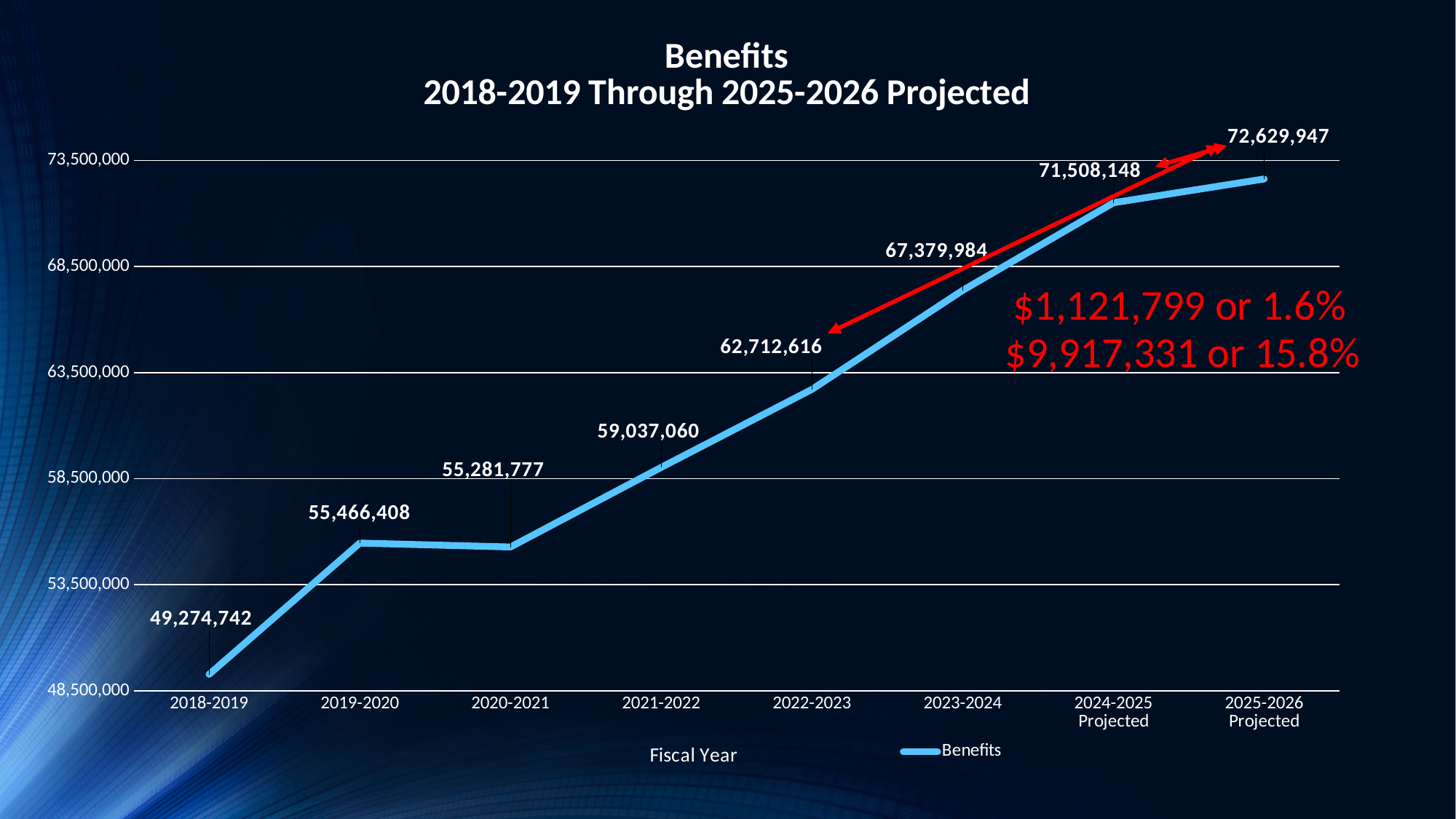
Which is larger, the Benefits value for 2019-2020 or for 2020-2021? 2019-2020 What is the Benefits value for 2022-2023? 62,712,616 Which fiscal year has the highest Benefits value? 2025-2026 Projected What is the projected Benefits value for 2025-2026? 72,629,947 What is the difference between the Benefits values for 2019-2020 and 2020-2021? 184,631 How many fiscal years are plotted on the chart? 8 What kind of chart is shown on the slide? Line chart How many series does the legend list? 1 What is the Benefits value for 2018-2019? 49,274,742 What is the difference between the Benefits values for 2025-2026 Projected and 2024-2025 Projected? 1,121,799 Which fiscal year has the lowest Benefits value? 2018-2019 Do the Benefits values generally rise or fall from 2018-2019 to 2025-2026 Projected? Rise